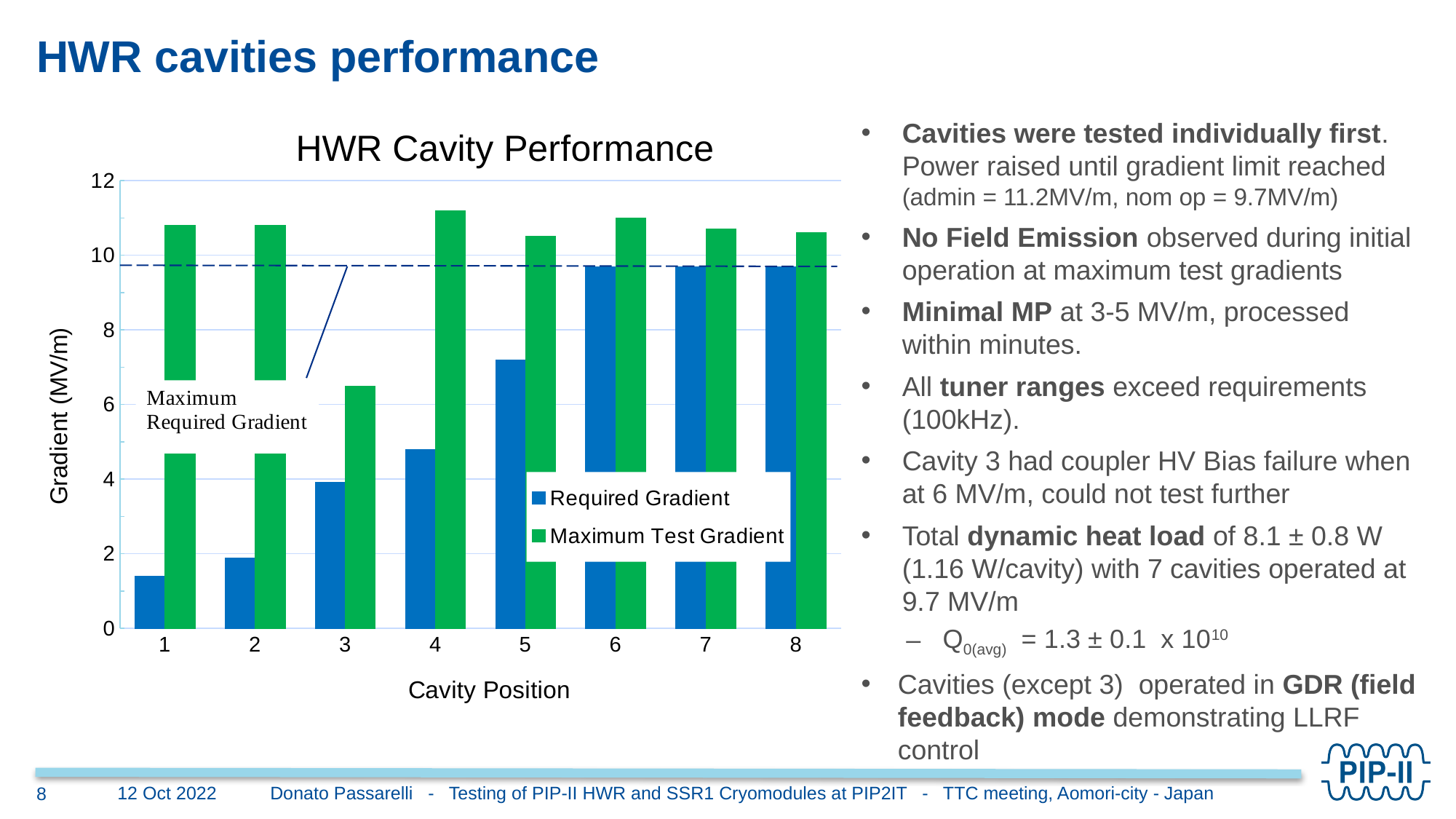
What is the title of the chart? HWR Cavity Performance Is the Maximum Test Gradient for cavity position 1 greater or less than 10 MV/m? greater What is the label of the y axis of the chart? Gradient (MV/m) What kind of chart is shown on the slide? bar chart How many cavity positions are shown on the x axis of the chart? 8 Does the Required Gradient rise or fall as the cavity position increases from 1 to 8? rise Which cavity position has the lowest Maximum Test Gradient? 3 For cavity position 3, which is larger: the Required Gradient or the Maximum Test Gradient? Maximum Test Gradient How many series does the legend of the HWR Cavity Performance chart list? 2 Is the Required Gradient for cavity position 1 greater or less than 2 MV/m? less Is the Maximum Test Gradient for cavity position 3 greater or less than 8 MV/m? less